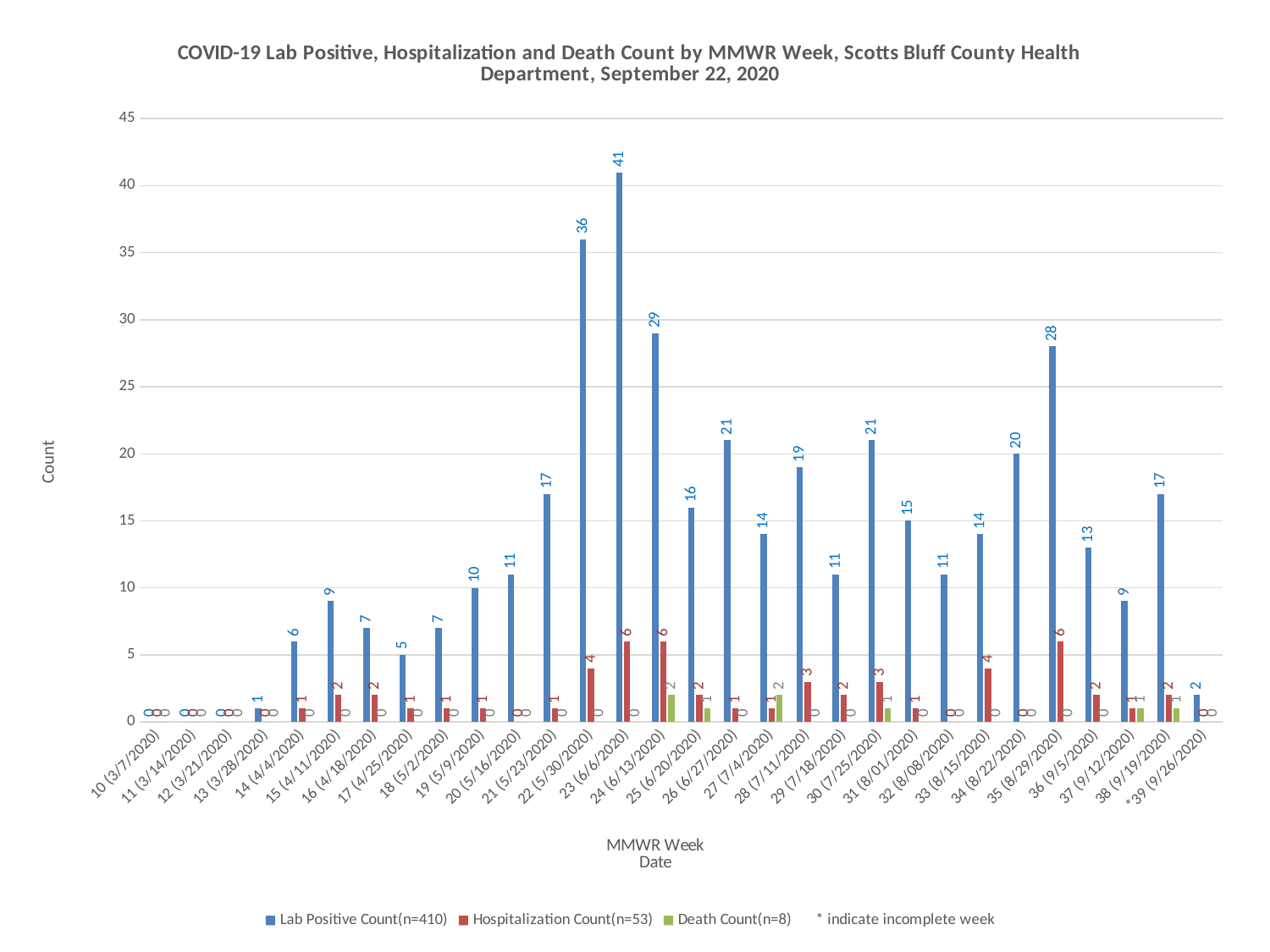
How many series does the legend list? 3 What is the Lab Positive Count for MMWR week 23 (6/6/2020)? 41 What kind of chart is shown on the slide? bar chart Which MMWR week has the highest Lab Positive Count? 23 (6/6/2020) What is the Hospitalization Count for MMWR week 22 (5/30/2020)? 4 Is the Lab Positive Count for week 24 (6/13/2020) greater or less than 25? greater Which is larger, the Lab Positive Count for week 35 (8/29/2020) or for week 34 (8/22/2020)? 35 (8/29/2020) Does the Lab Positive Count rise or fall from week 19 (5/9/2020) to week 23 (6/6/2020)? rise What is the difference between the Lab Positive Count for week 22 (5/30/2020) and week 23 (6/6/2020)? 5 How many MMWR weeks are shown on the x axis? 30 According to the legend, what is the total n for the Hospitalization Count series? 53 What is the Death Count for MMWR week 24 (6/13/2020)? 2